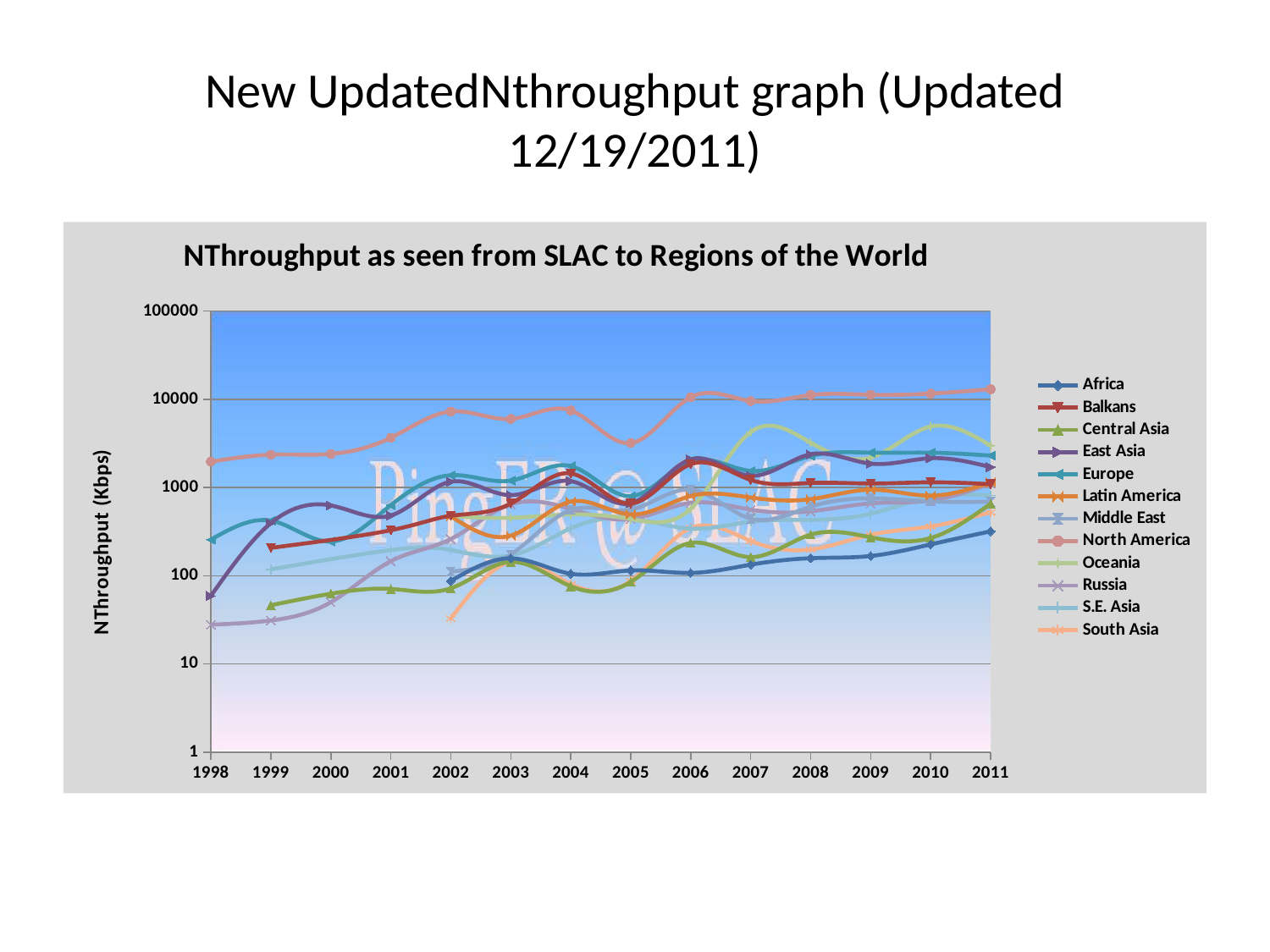
What kind of chart is shown on the slide? line chart Does the North America line generally rise or fall from 1998 to 2011? rise How many series does the legend list? 12 What is the title of the chart? NThroughput as seen from SLAC to Regions of the World How many years are shown along the x axis? 14 Is the value for Africa in 2011 greater or less than 1000? less Which region has the lowest throughput in 2011? Africa Which region has the highest throughput in 2011? North America Is the value for North America in 2011 greater or less than 10000? greater Is the value for Russia in 1998 greater or less than 100? less Which is larger in 2011, the value for Europe or the value for Central Asia? Europe What is the label of the y axis? NThroughput (Kbps)